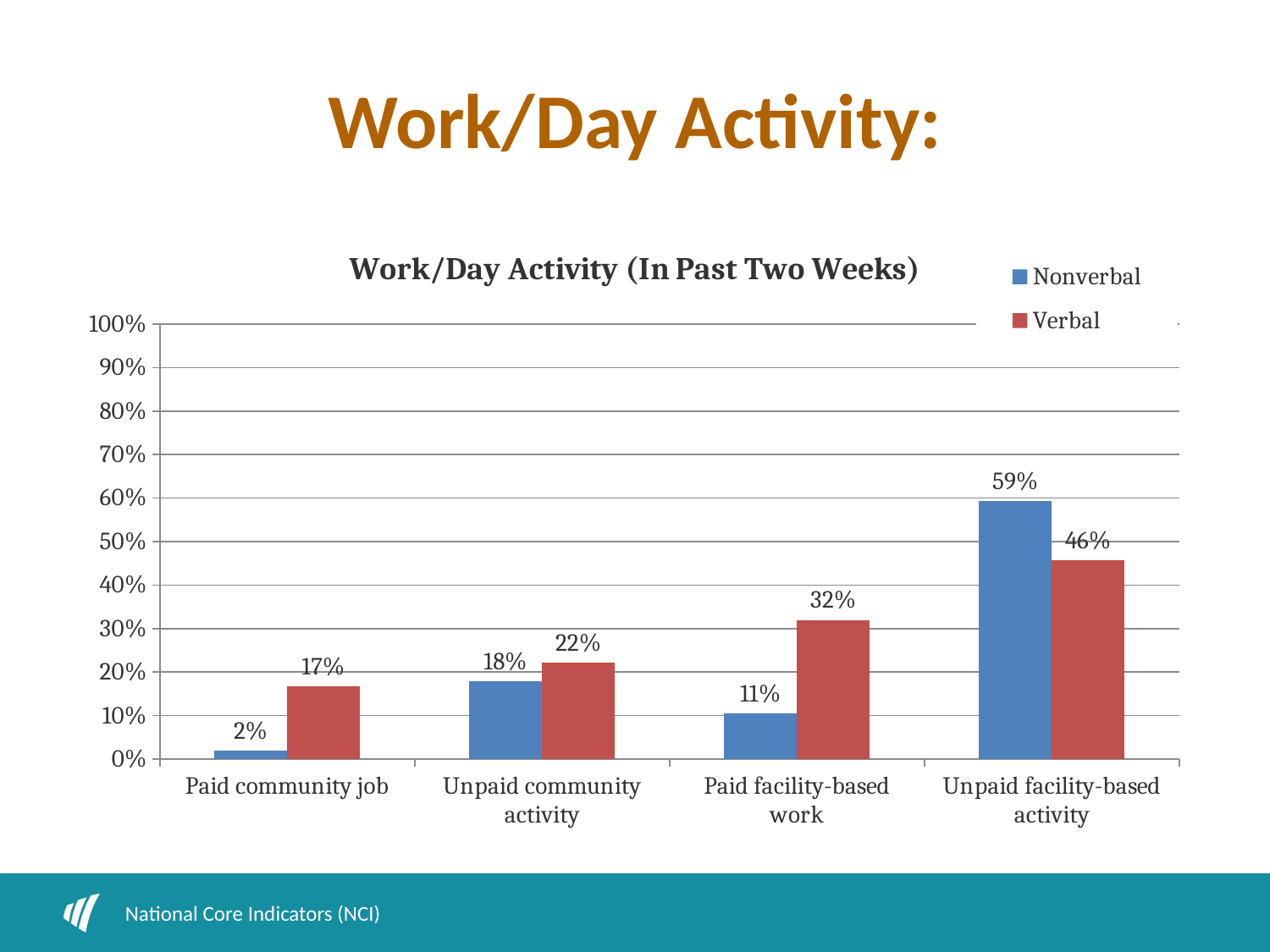
What is the difference between the Verbal and Nonverbal values for Paid facility-based work? 21% What kind of chart is shown on the slide? bar chart What is the Verbal value for Paid facility-based work? 32% Is the Verbal value for Unpaid community activity greater or less than 30%? less Which category has the lowest Nonverbal value? Paid community job How many categories are shown on the x axis? 4 What is the title of the chart? Work/Day Activity (In Past Two Weeks) What is the Nonverbal value for Unpaid facility-based activity? 59% What is the Nonverbal value for Paid community job? 2% Which category has the highest Verbal value? Unpaid facility-based activity Which is larger for Unpaid facility-based activity, the Nonverbal or the Verbal value? Nonverbal How many series does the legend list? 2